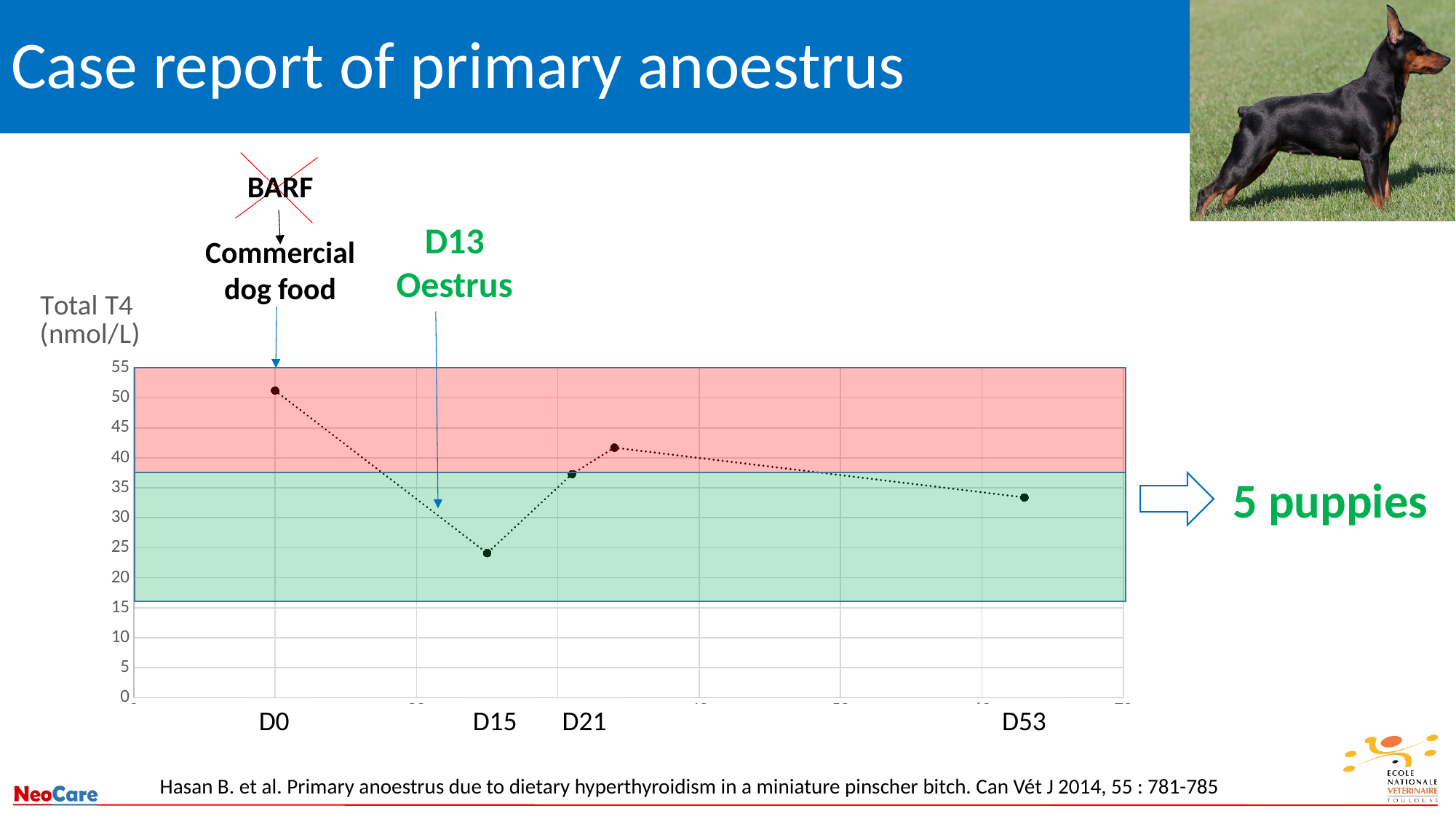
Which has the higher Total T4 value, D0 or D53? D0 Is the Total T4 value at D0 greater or less than 45? greater Which coloured band does the D15 data point fall in, the red band or the green band? green band Is the Total T4 value at D21 greater or less than 40? less How many day labels (D0, D15, ...) are shown along the x axis of the chart? 4 Is the Total T4 value at D53 greater or less than 30? greater Does the Total T4 value rise or fall from D0 to D15? fall What is the label of the y axis of the chart? Total T4 (nmol/L) At which labelled day is the Total T4 value lowest? D15 What kind of chart is shown on the slide? line chart At which labelled day is the Total T4 value highest? D0